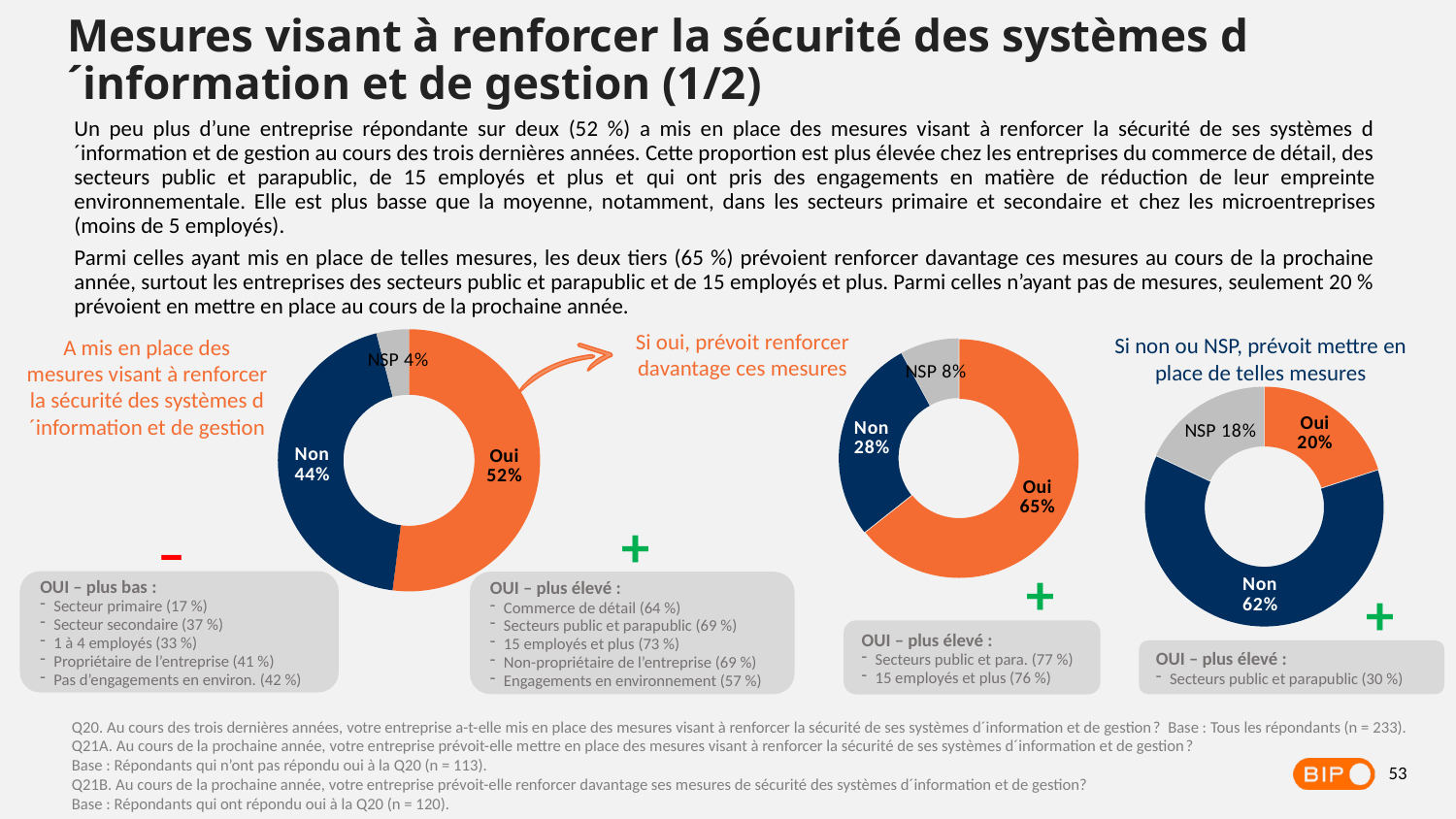
In the left donut chart (A mis en place des mesures...), what is the value for NSP? 4% In the left donut chart (A mis en place des mesures...), what is the value for Non? 44% Which is larger in the right donut chart (Si non ou NSP, prévoit mettre en place de telles mesures): Oui or NSP? Oui In the middle donut chart (Si oui, prévoit renforcer davantage ces mesures), what is the value for Oui? 65% In the right donut chart (Si non ou NSP, prévoit mettre en place de telles mesures), which category has the largest share? Non In the left donut chart (A mis en place des mesures...), what is the difference between Oui and Non? 8% In the right donut chart (Si non ou NSP, prévoit mettre en place de telles mesures), what is the value for NSP? 18% In the middle donut chart (Si oui, prévoit renforcer davantage ces mesures), what is the value for Non? 28% In the left donut chart (A mis en place des mesures visant à renforcer la sécurité des systèmes d'information et de gestion), what is the value for Oui? 52% In the right donut chart (Si non ou NSP, prévoit mettre en place de telles mesures), what is the value for Non? 62% How many donut charts are shown on the slide? 3 In the middle donut chart (Si oui, prévoit renforcer davantage ces mesures), which category has the smallest share? NSP